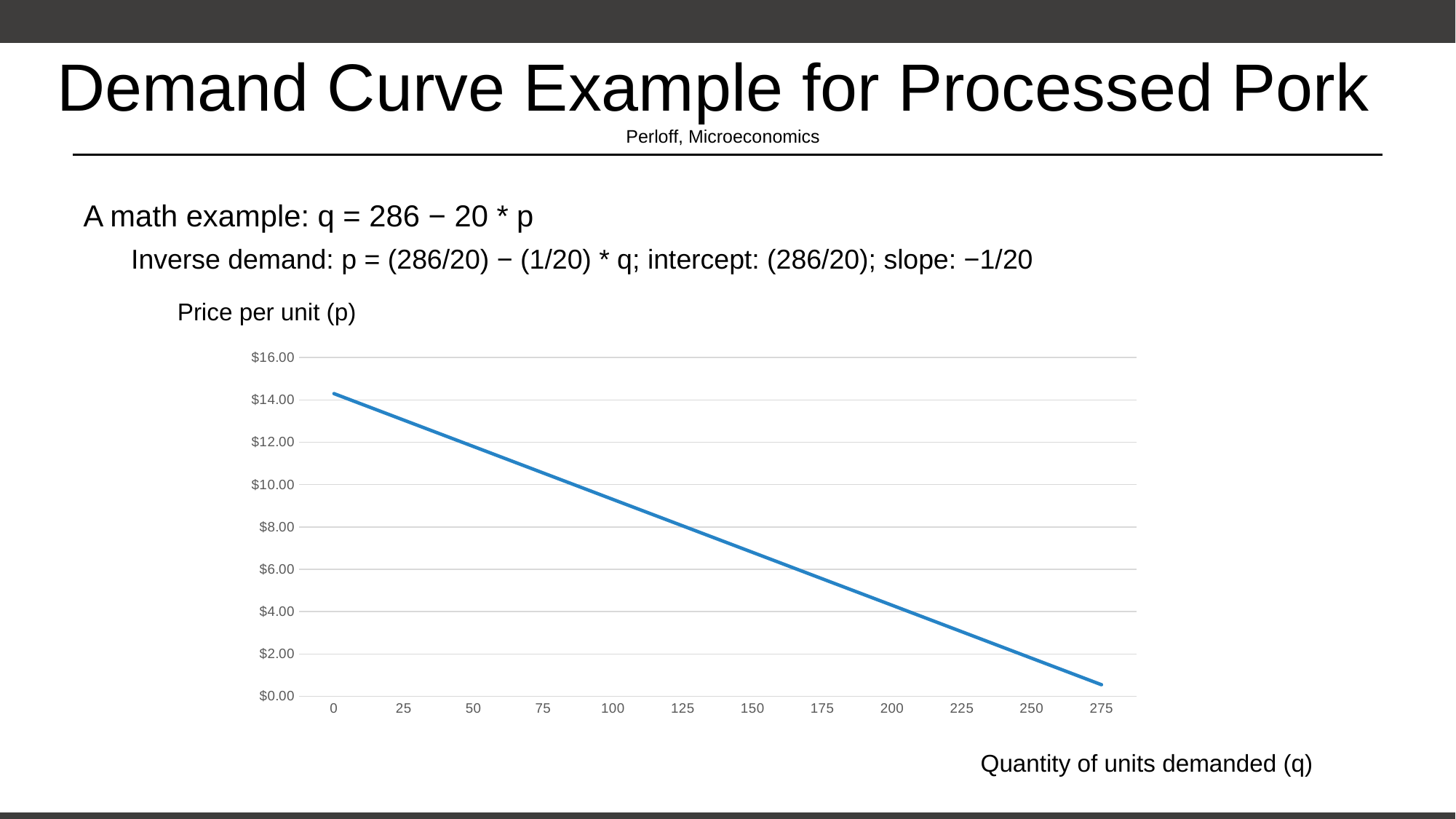
What is the label of the horizontal axis of the chart? Quantity of units demanded (q) Which quantity has the higher price on the curve, 25 or 250? 25 Is the price at a quantity of 200 greater or less than $6.00? less At which quantity on the x axis is the price highest? 0 Is the price at a quantity of 275 greater or less than $2.00? less At which quantity on the x axis is the price lowest? 275 How many tick labels are shown on the x axis? 12 Does the price fall or rise as the quantity demanded increases along the x axis? fall Is the price at a quantity of 100 greater or less than $10.00? less What kind of chart is shown on the slide? line chart